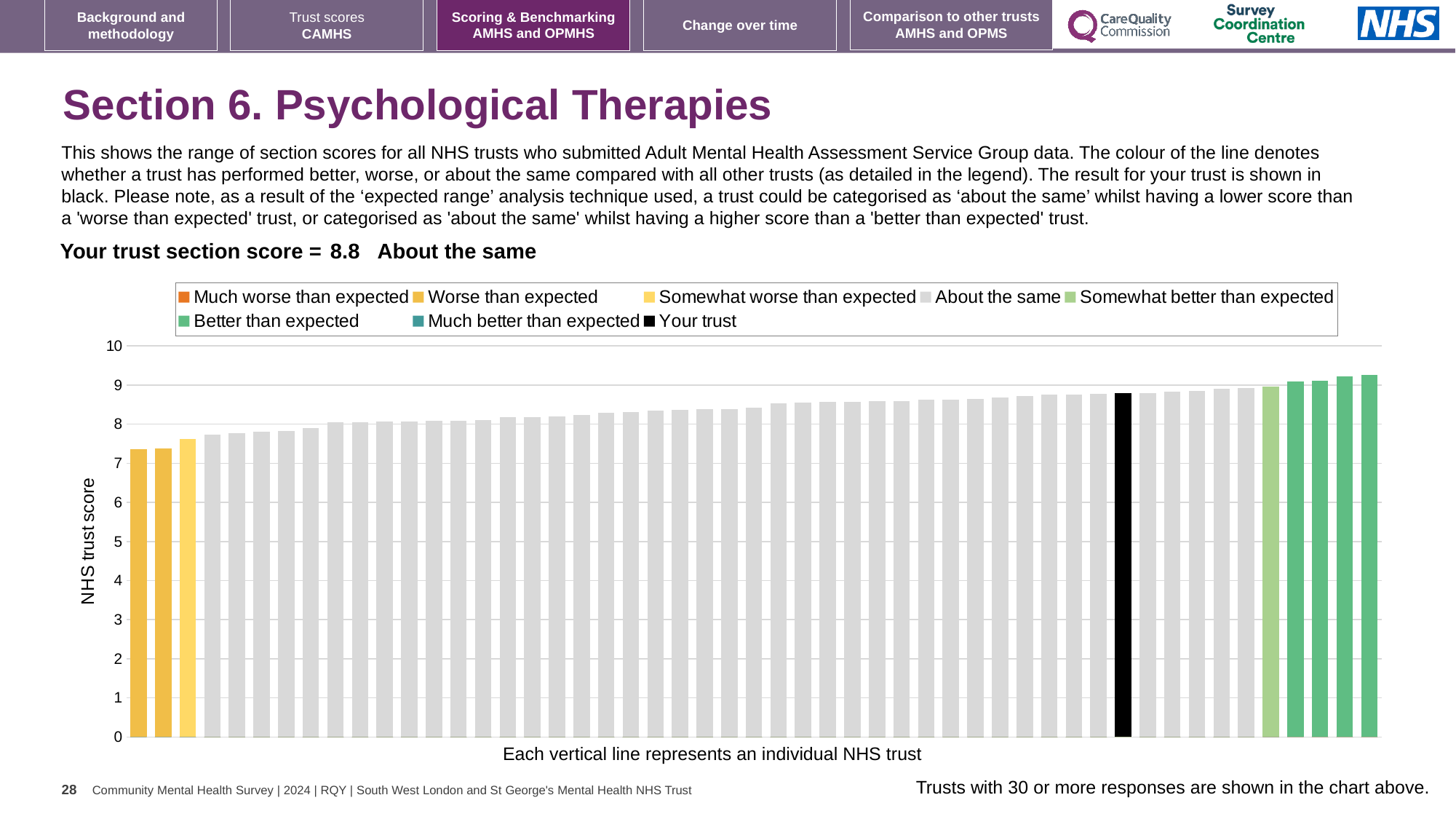
How many bars are coloured as 'Worse than expected' on the chart? 2 What is the section score for your trust shown on the chart? 8.8 Which category is your trust's section score placed in, according to the slide? About the same Is the value for your trust (the black bar) greater or less than 9? less How many entries does the chart legend list? 8 Is the value of the lowest bar on the chart greater or less than 8? less What kind of chart is shown on the slide? bar chart Is the value for your trust (the black bar) greater or less than 8? greater How many bars are coloured as 'Better than expected' on the chart? 4 What is the label on the vertical axis of the chart? NHS trust score Do the bar values rise or fall from left to right across the chart? rise